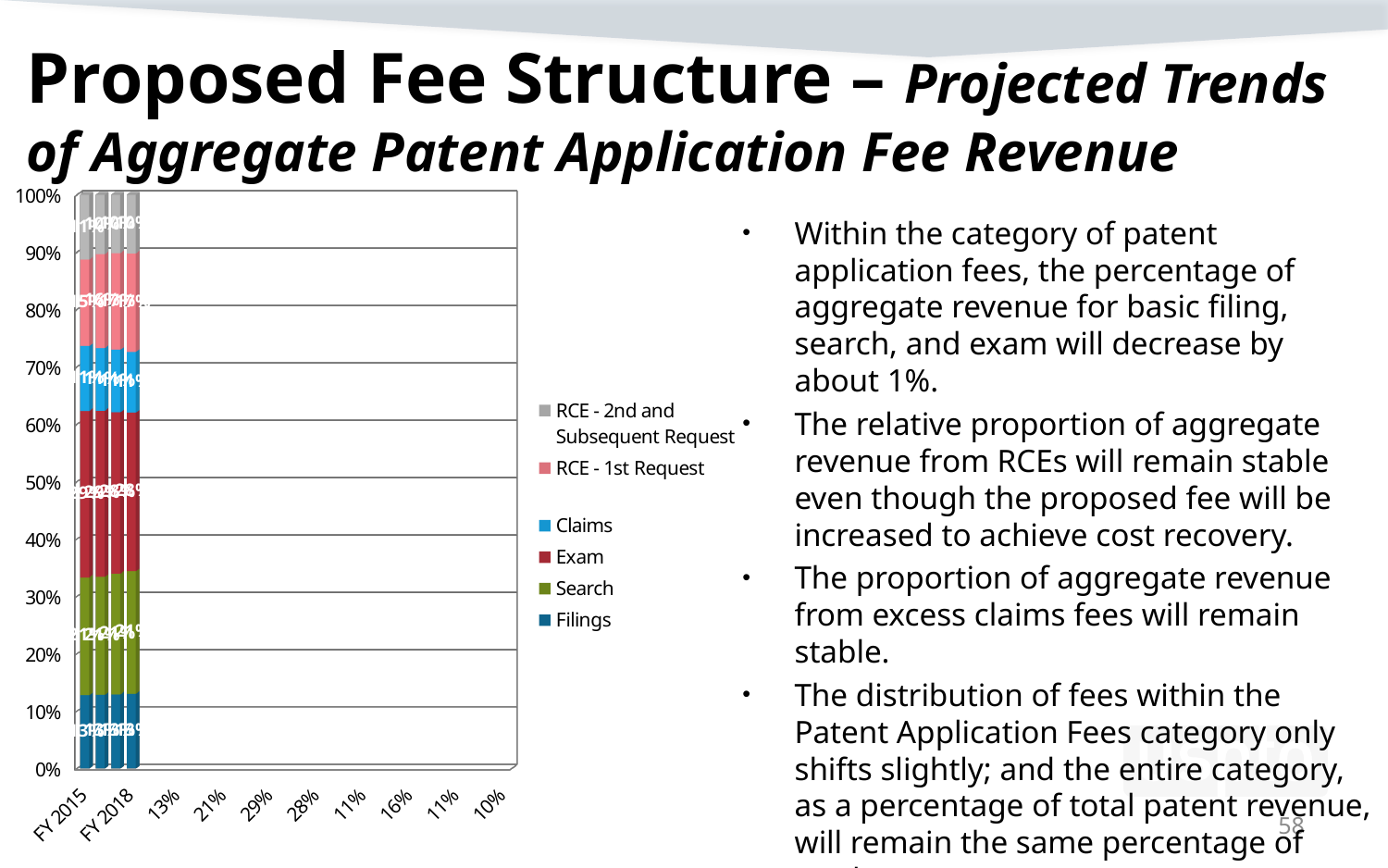
Which series has a larger share of the stacked bar, Search or RCE - 2nd and Subsequent Request? Search What kind of chart is shown on the slide? Stacked bar chart Which series takes up the largest share of each stacked bar? Exam Is the share of the stacked bar for Filings greater or less than 20%? less Is the share of the stacked bar for RCE - 2nd and Subsequent Request greater or less than 20%? less Is the share of the stacked bar for Exam greater or less than 20%? greater Which series has a larger share of the stacked bar, Exam or Claims? Exam What is the highest value shown on the chart's vertical axis? 100% Which series is shown in green in the chart? Search Which series is listed first (at the top) in the chart's legend? RCE - 2nd and Subsequent Request How many series does the chart's legend list? 6